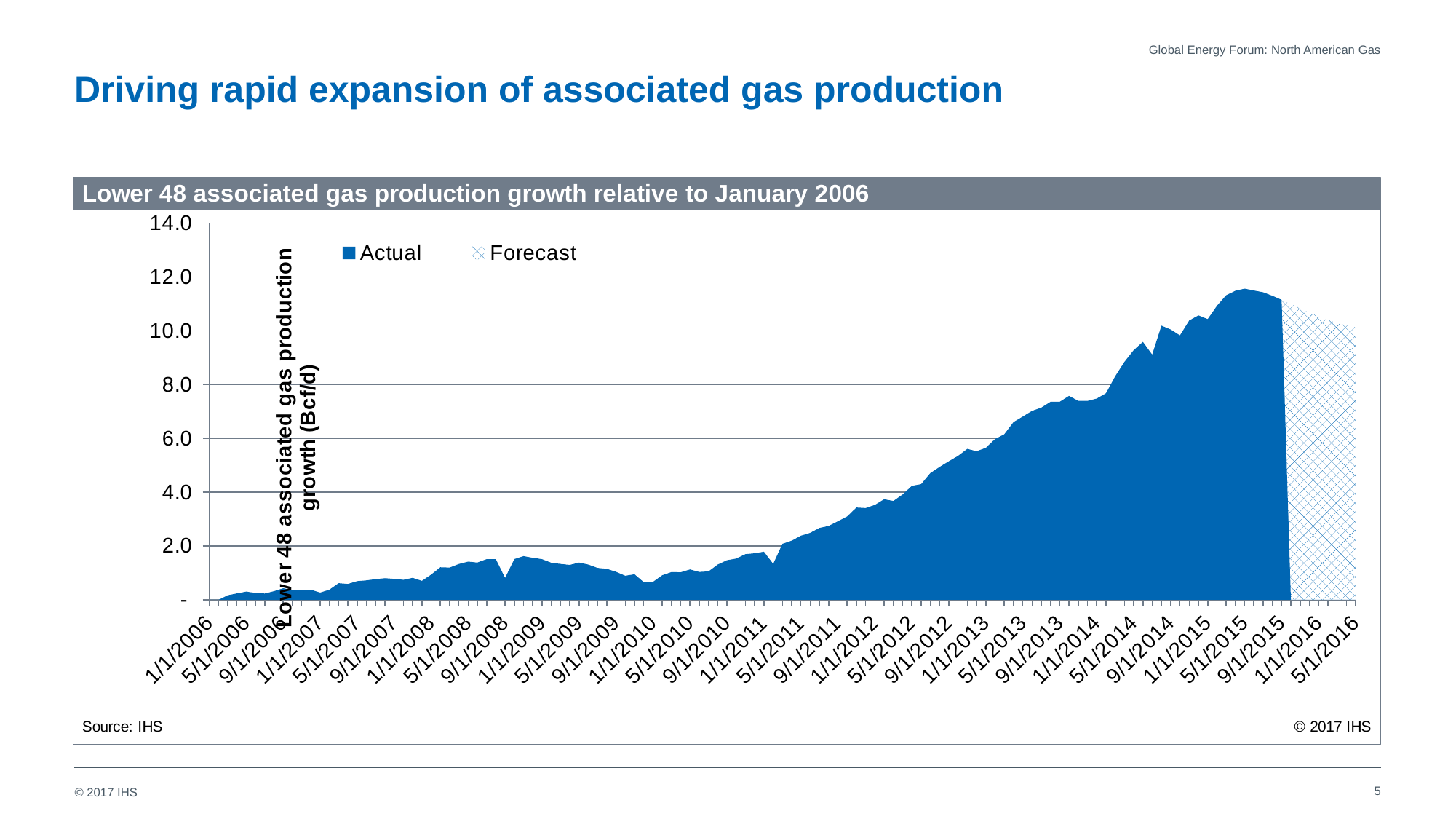
What is the title of the chart? Lower 48 associated gas production growth relative to January 2006 How many series does the legend list? 2 Is the value for 1/1/2009 greater or less than 4.0? less Is the value for 1/1/2010 greater or less than 2.0? less Is the value for 1/1/2012 greater or less than 2.0? greater Overall, do the Actual values rise or fall from 1/1/2006 to 9/1/2015? Rise What are the two series named in the legend? Actual and Forecast Which is larger, the value for 1/1/2015 or the value for 1/1/2010? 1/1/2015 What kind of chart is shown on the slide? Area chart